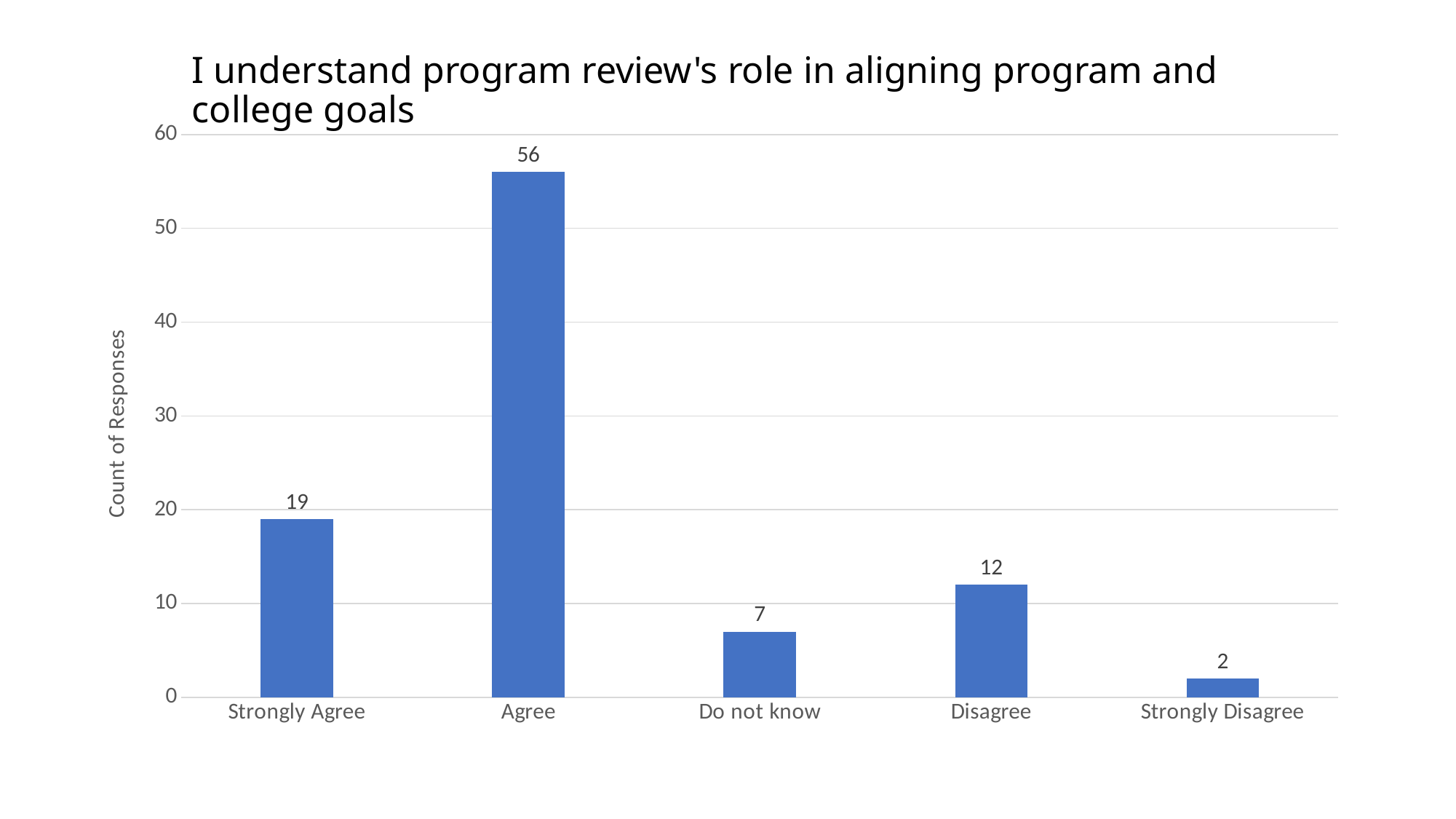
What kind of chart is shown on the slide? Bar chart What is the count of responses for Strongly Agree? 19 What is the count of responses for Strongly Disagree? 2 Which has more responses, Disagree or Do not know? Disagree What is the label of the vertical axis? Count of Responses What is the difference between the counts for Agree and Strongly Agree? 37 Is the value for Strongly Agree greater or less than 20? less What is the count of responses for Do not know? 7 Which response category has the highest count? Agree Which response category has the lowest count? Strongly Disagree What is the count of responses for Agree? 56 How many response categories are shown on the x axis? 5